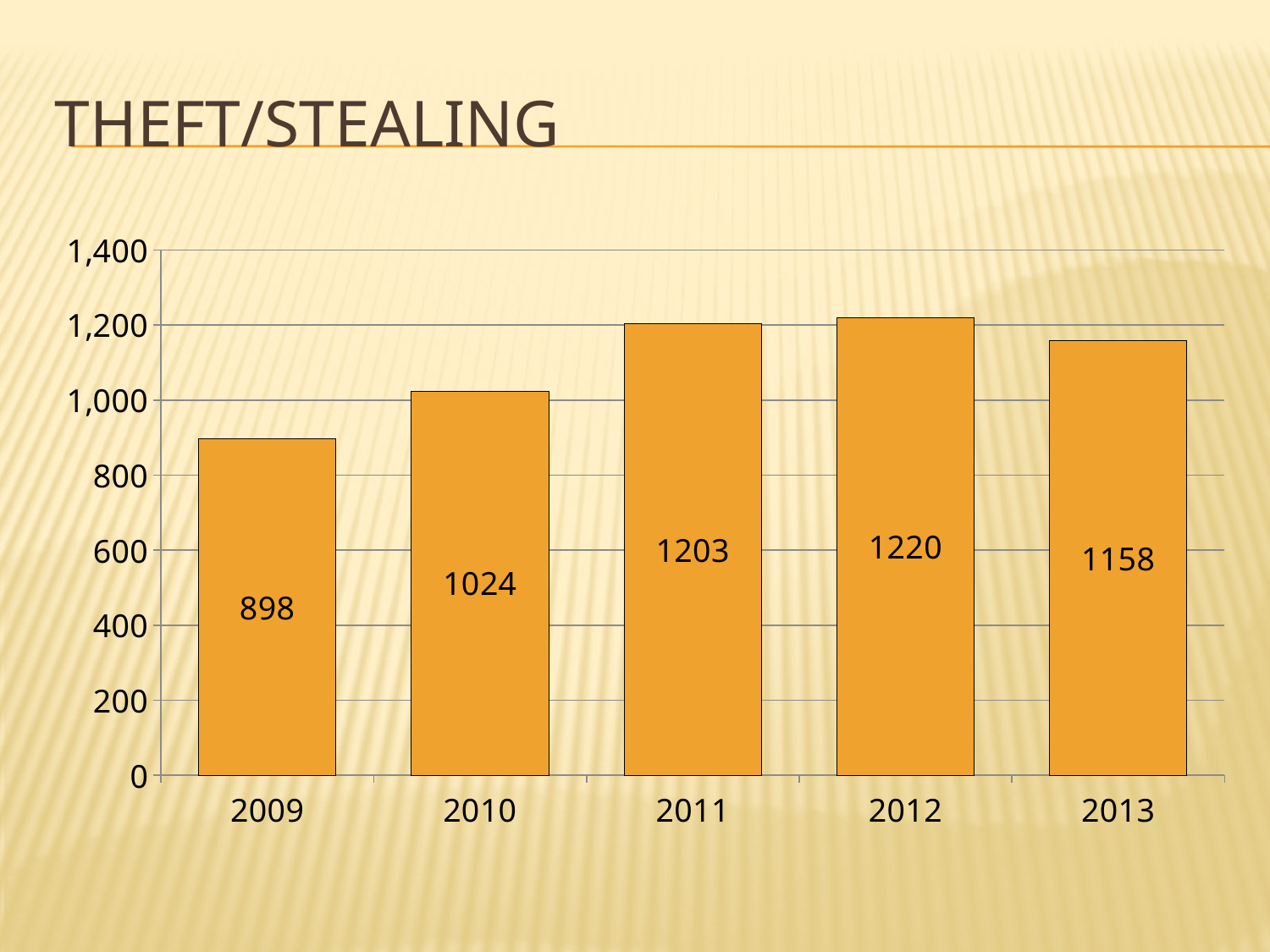
What is the value for 2013? 1158 What kind of chart is shown on the slide? bar chart Which is larger, the value for 2010 or the value for 2013? 2013 What is the difference between the values for 2010 and 2009? 126 How many years are shown on the x axis? 5 Which year has the highest value? 2012 What is the difference between the values for 2012 and 2013? 62 Is the value for 2009 greater or less than 1,000? less What is the value for 2011? 1203 What is the value for 2009? 898 What is the title of the slide? THEFT/STEALING Which year has the lowest value? 2009